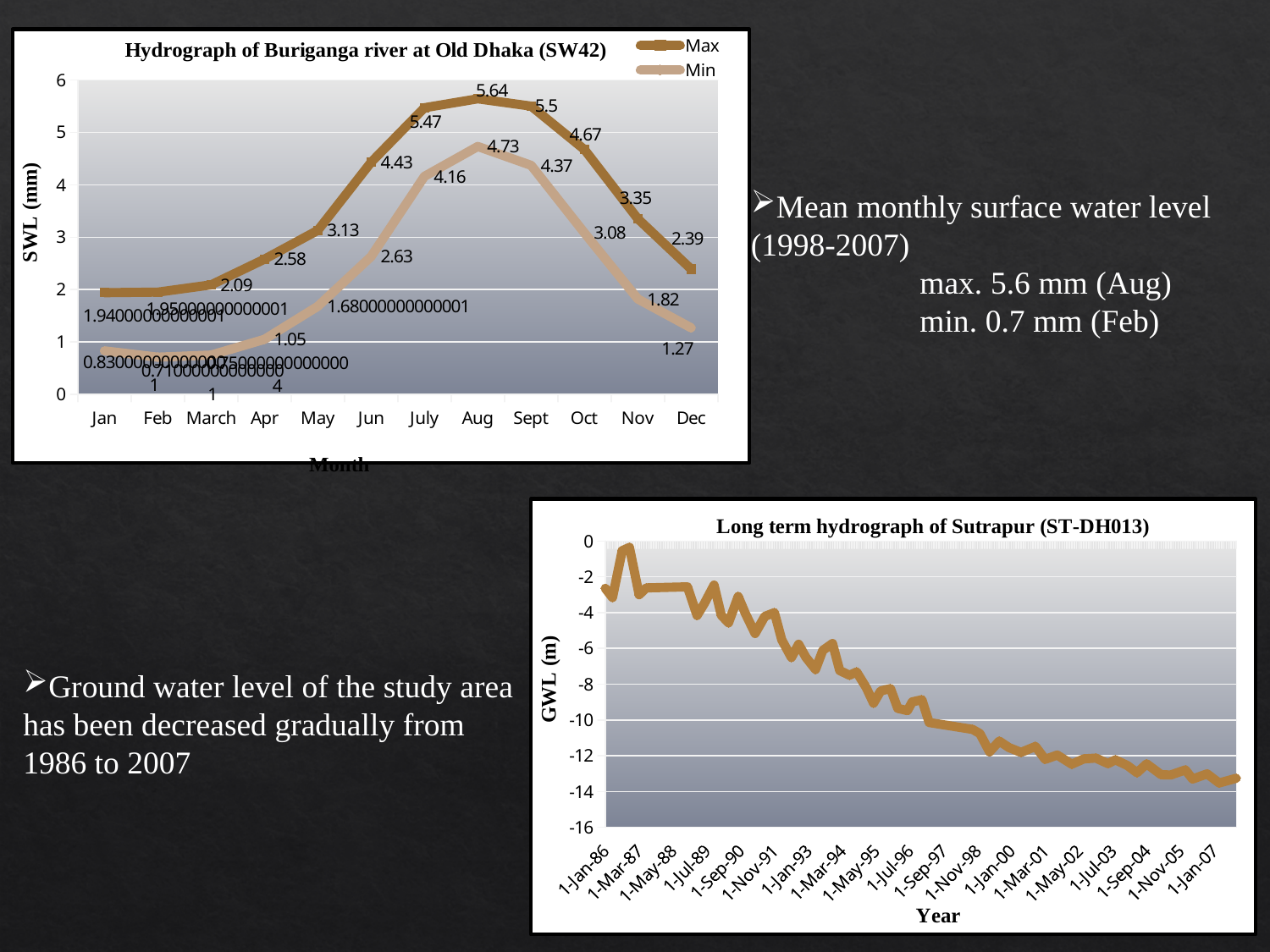
What kind of chart is 'Long term hydrograph of Sutrapur (ST-DH013)'? Line chart What is the y-axis label of the chart titled 'Long term hydrograph of Sutrapur (ST-DH013)'? GWL (m) In the chart titled 'Hydrograph of Buriganga river at Old Dhaka (SW42)', how many series does the legend list? 2 In the chart titled 'Hydrograph of Buriganga river at Old Dhaka (SW42)', what is the Min value for Oct? 3.08 In the chart titled 'Hydrograph of Buriganga river at Old Dhaka (SW42)', what is the Min value for Apr? 1.05 In the chart titled 'Long term hydrograph of Sutrapur (ST-DH013)', do the values rise or fall from 1986 to 2007? Fall In the chart titled 'Hydrograph of Buriganga river at Old Dhaka (SW42)', how many months are shown on the x axis? 12 In the chart titled 'Hydrograph of Buriganga river at Old Dhaka (SW42)', which is larger: the Max value for Nov or the Max value for Dec? Nov In the chart titled 'Hydrograph of Buriganga river at Old Dhaka (SW42)', what is the Max value for Aug? 5.64 In the chart titled 'Hydrograph of Buriganga river at Old Dhaka (SW42)', what is the difference between the Max and Min values for July? 1.31 In the chart titled 'Hydrograph of Buriganga river at Old Dhaka (SW42)', which month has the highest Max value? Aug In the chart titled 'Long term hydrograph of Sutrapur (ST-DH013)', is the value at 1-Jan-07 greater or less than -12? less